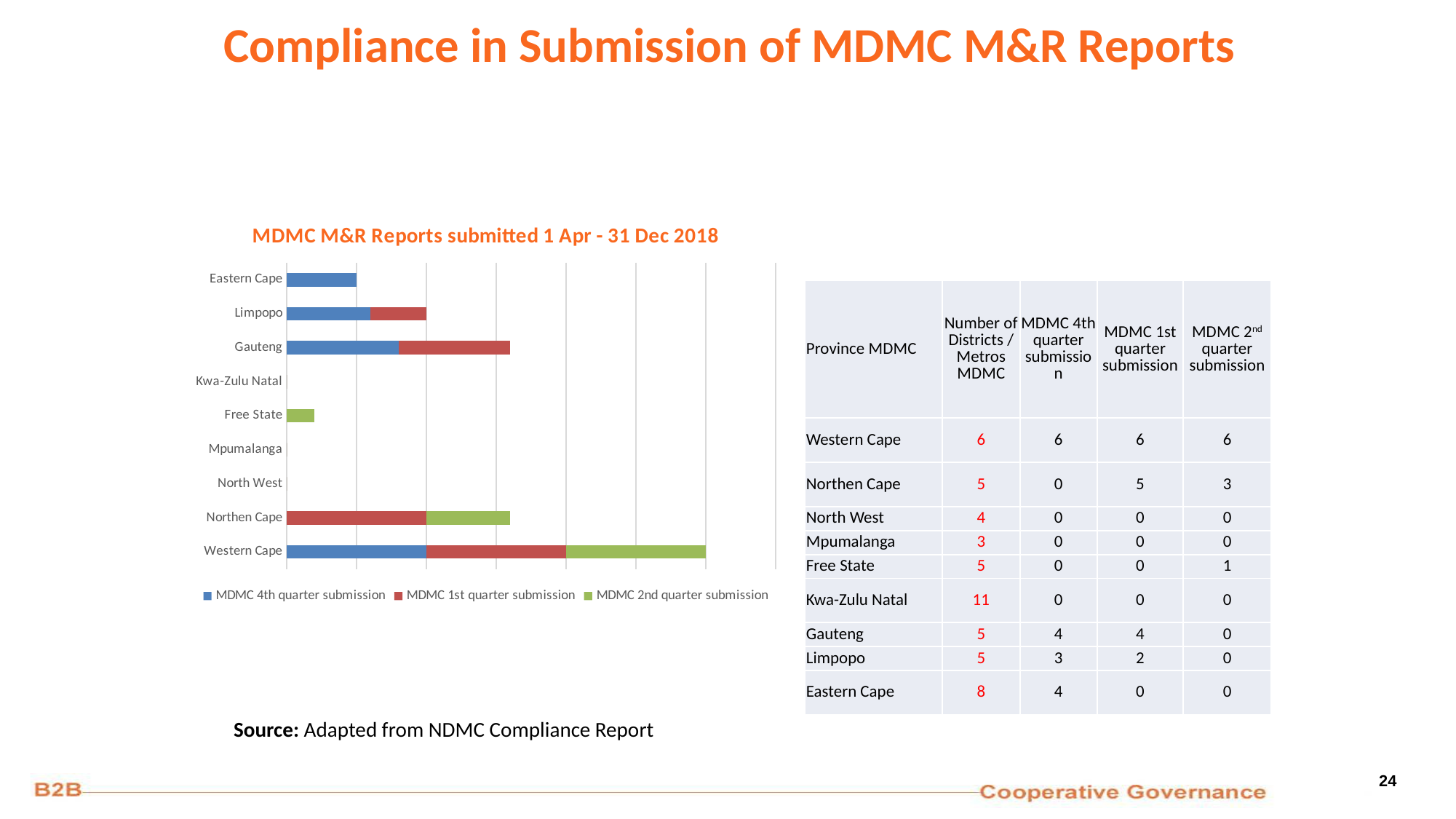
How many provinces are listed on the chart's vertical axis? 9 What kind of chart is shown on the slide? Stacked bar chart Which has the longer total bar, Gauteng or Limpopo? Gauteng What is the difference between the MDMC 4th quarter submission values for Western Cape and Limpopo? 3 What is the MDMC 1st quarter submission value for Gauteng? 4 What is the title of the chart? MDMC M&R Reports submitted 1 Apr - 31 Dec 2018 What is the MDMC 2nd quarter submission value for Free State? 1 What is the MDMC 4th quarter submission value for Western Cape? 6 Which province has the longest total bar in the chart? Western Cape How many series does the chart legend list? 3